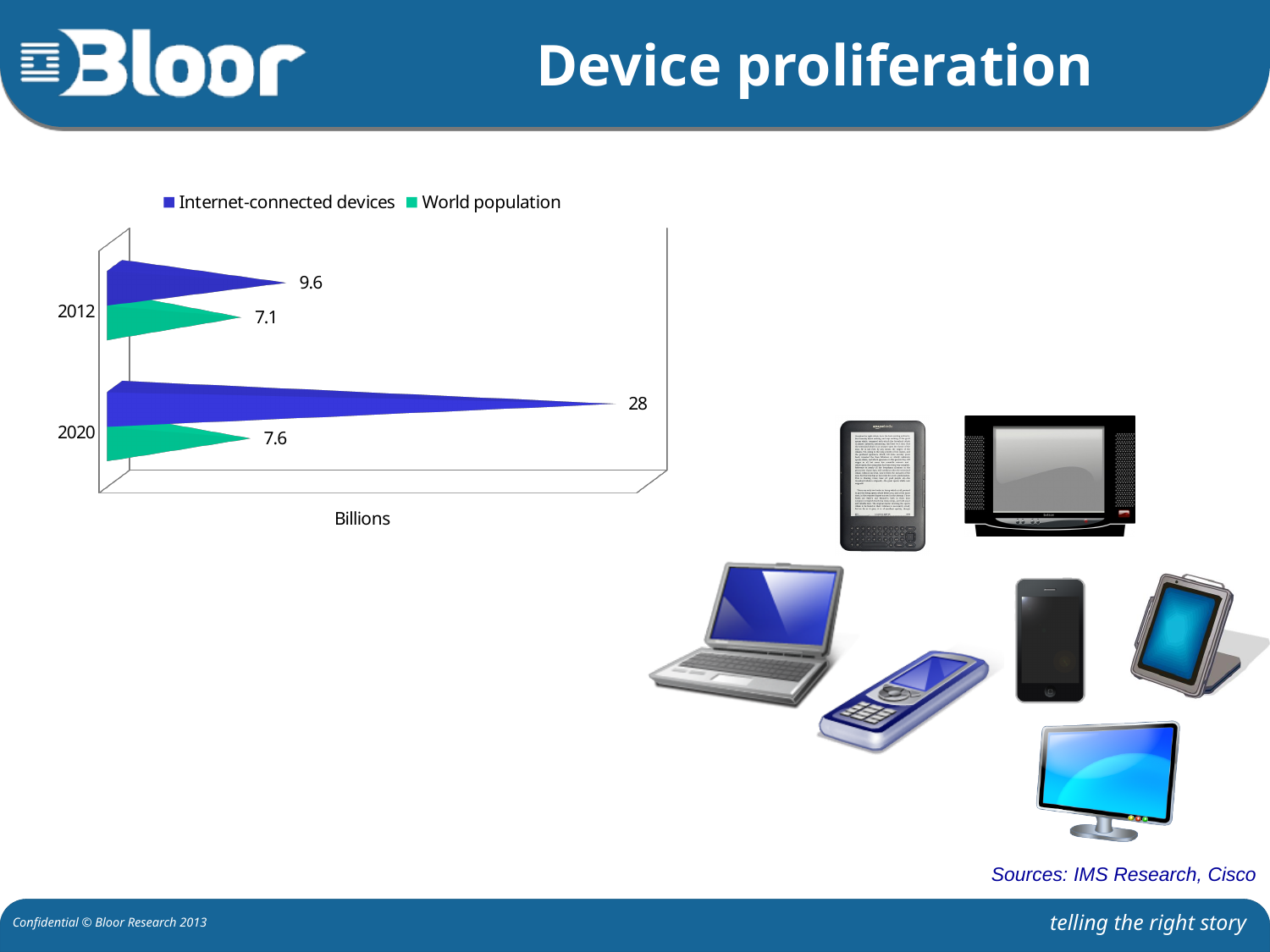
How many series does the legend list? 2 Which year has the lowest value for World population? 2012 What is the difference between Internet-connected devices in 2020 and in 2012? 18.4 What is the value for World population in 2012? 7.1 Which is larger in 2012: Internet-connected devices or World population? Internet-connected devices What is the value for Internet-connected devices in 2012? 9.6 What is the difference between Internet-connected devices and World population in 2020? 20.4 What is the value for World population in 2020? 7.6 How many years are shown on the chart? 2 What is the value for Internet-connected devices in 2020? 28 Which year has the highest value for Internet-connected devices? 2020 What unit is shown on the chart's axis label? Billions